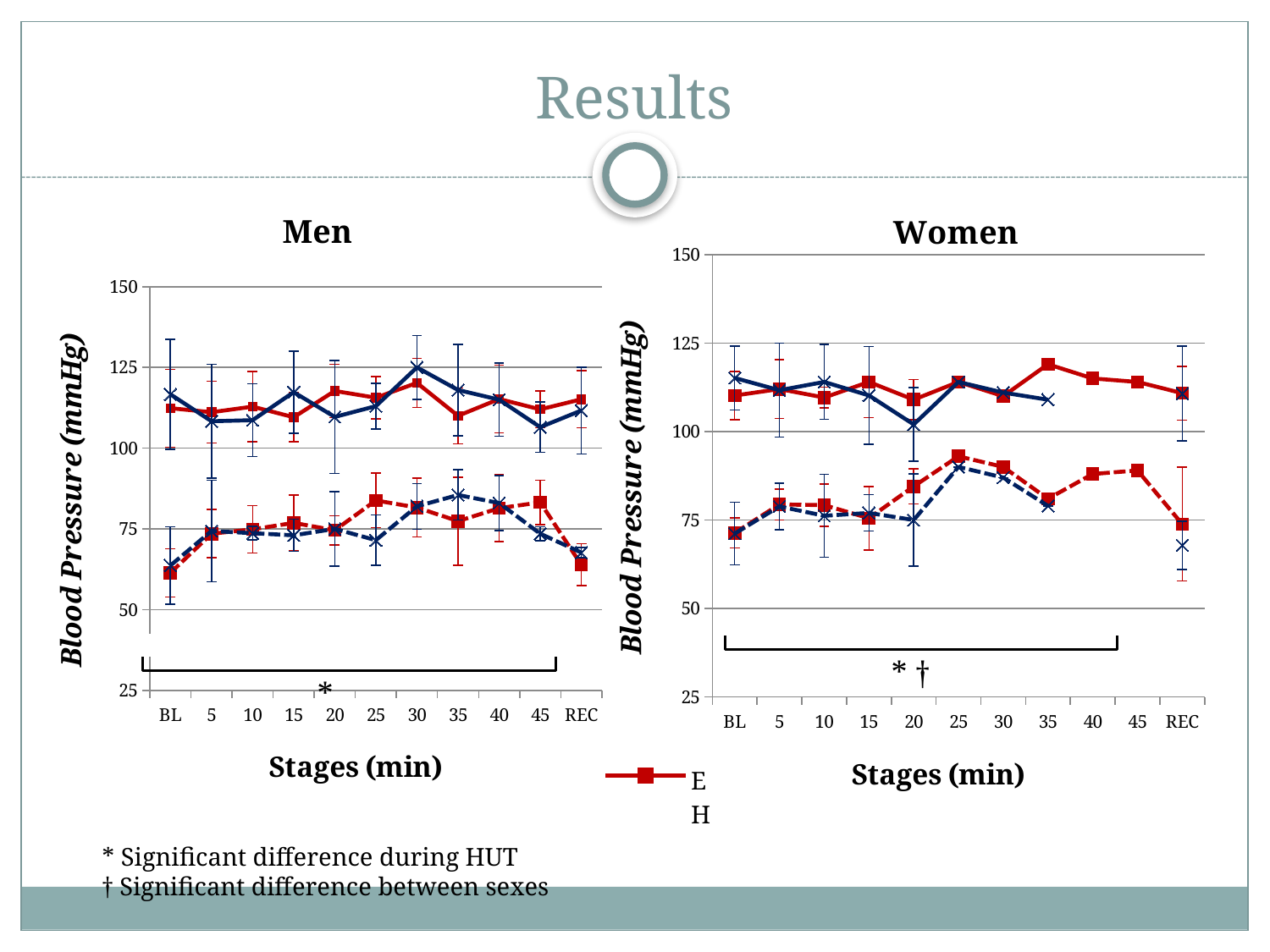
What kind of chart is the Men chart? line chart In the Men chart, at stage 35, which dashed line is higher: the red E line or the blue H line? the blue H line In the Women chart, is the value of the solid red E line at 35 greater or less than 100? greater How many series does the legend list? 2 In the Women chart, is the value of the dashed blue H line at REC greater or less than 75? less In the Men chart, is the value of the solid red E line at BL greater or less than 100? greater In the Women chart, at stage 20, which solid line is higher: the red E line or the blue H line? the red E line What are the two series named in the legend? E and H How many stages are shown on the x axis of the Women chart? 11 What is the y-axis label on the Men chart? Blood Pressure (mmHg)